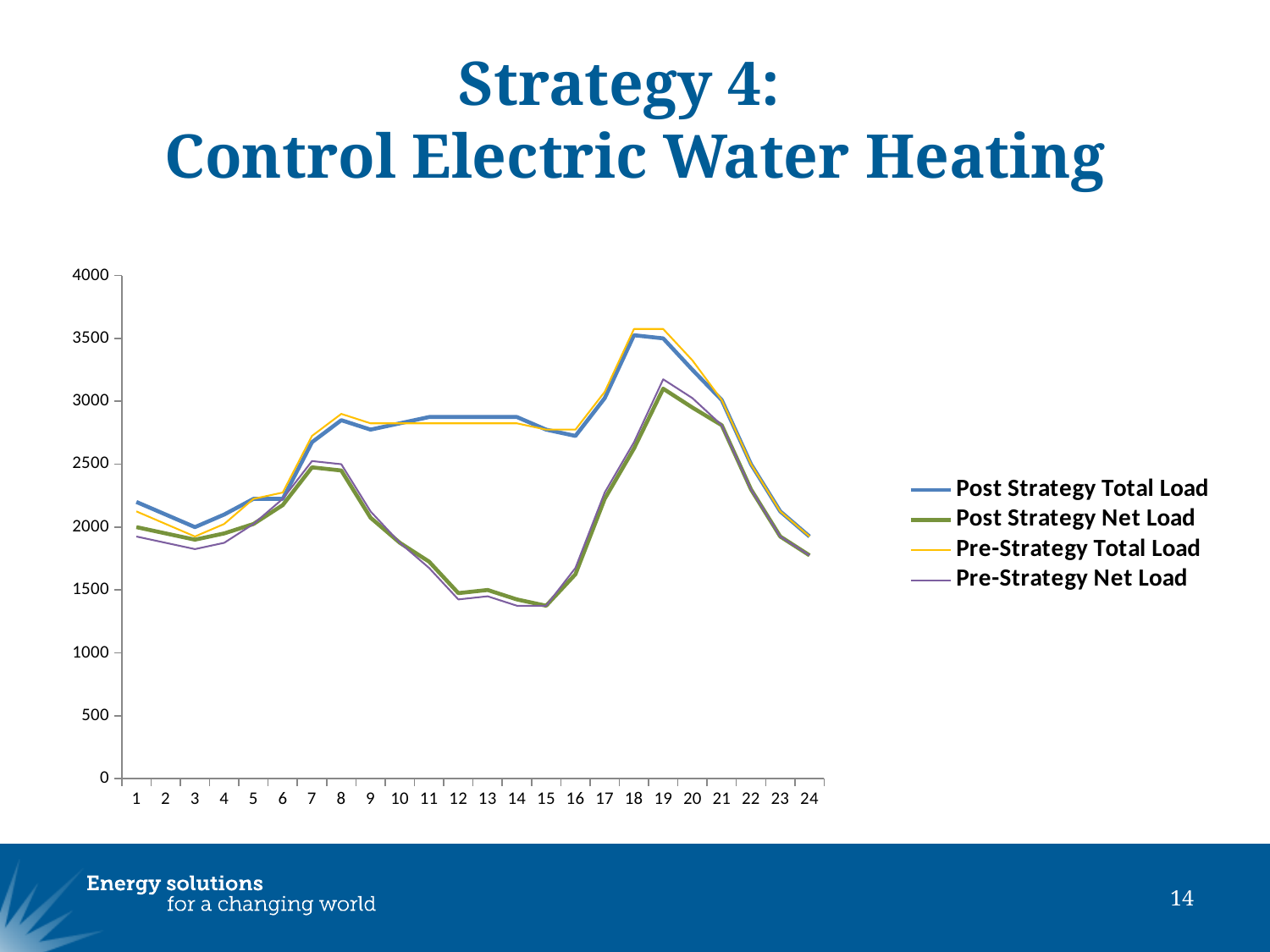
Is the Pre-Strategy Total Load value at hour 3 greater or less than 2500? less At hour 12, which is larger: Post Strategy Total Load or Post Strategy Net Load? Post Strategy Total Load What kind of chart is shown on the slide? line chart Does the Post Strategy Net Load rise or fall from hour 8 to hour 15? fall At which hour is the Post Strategy Net Load highest? 19 Which legend entry is drawn in green? Post Strategy Net Load Is the Post Strategy Net Load value at hour 15 greater or less than 1500? less Is the Post Strategy Total Load value at hour 18 greater or less than 3000? greater How many series does the legend list? 4 How many points are plotted along the x axis for each series? 24 Does the Post Strategy Total Load rise or fall from hour 16 to hour 18? rise